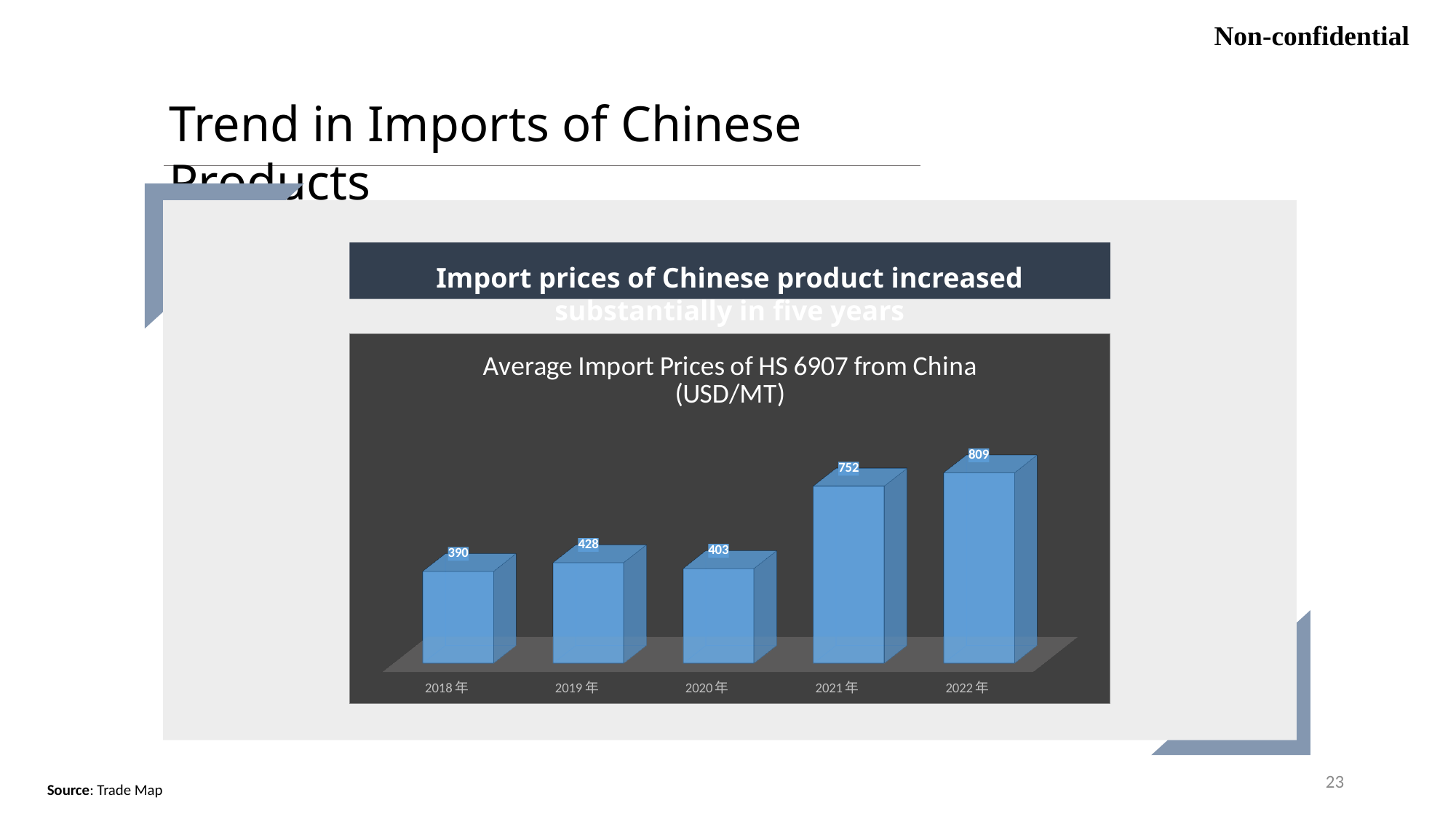
What is the average import price of HS 6907 from China in 2022? 809 Which year has the highest average import price? 2022 What kind of chart is shown on the slide? Bar chart Which year has the lowest average import price? 2018 Do the average import prices generally rise or fall from 2018 to 2022? Rise What is the average import price of HS 6907 from China in 2018? 390 What is the difference between the average import price in 2019 and in 2020? 25 What is the average import price of HS 6907 from China in 2021? 752 How many years are shown in the chart? 5 What is the difference between the average import price in 2022 and in 2018? 419 What unit is used for the values in the chart? USD/MT Which year has a higher average import price, 2019 or 2020? 2019